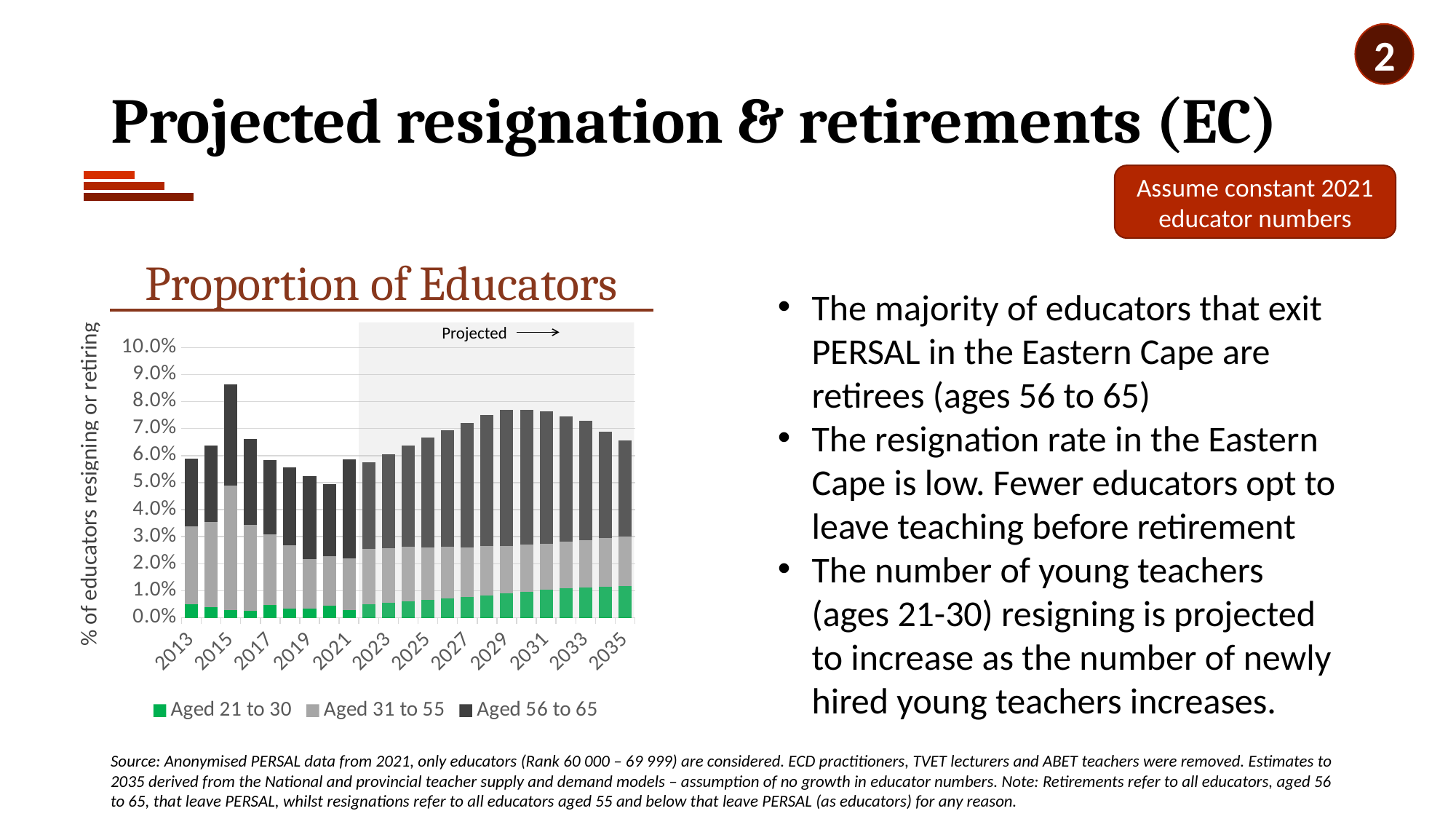
How many series does the chart legend list? 3 Do the total bar values rise or fall from 2022 to 2030? Rise Is the total value for 2020 greater or less than 6.0%? less What kind of chart is shown on the slide? Stacked bar chart Which year has the larger total bar, 2015 or 2016? 2015 Is the total value for 2015 greater or less than 8.0%? greater What are the three series listed in the chart legend? Aged 21 to 30, Aged 31 to 55, Aged 56 to 65 Which year has the highest total proportion of educators resigning or retiring? 2015 Which age group makes up the largest segment of the bar for 2030? Aged 56 to 65 Is the total value for 2030 greater or less than 7.0%? greater What is the title of the chart? Proportion of Educators How many years (bars) are plotted on the chart, from 2013 to 2035? 23